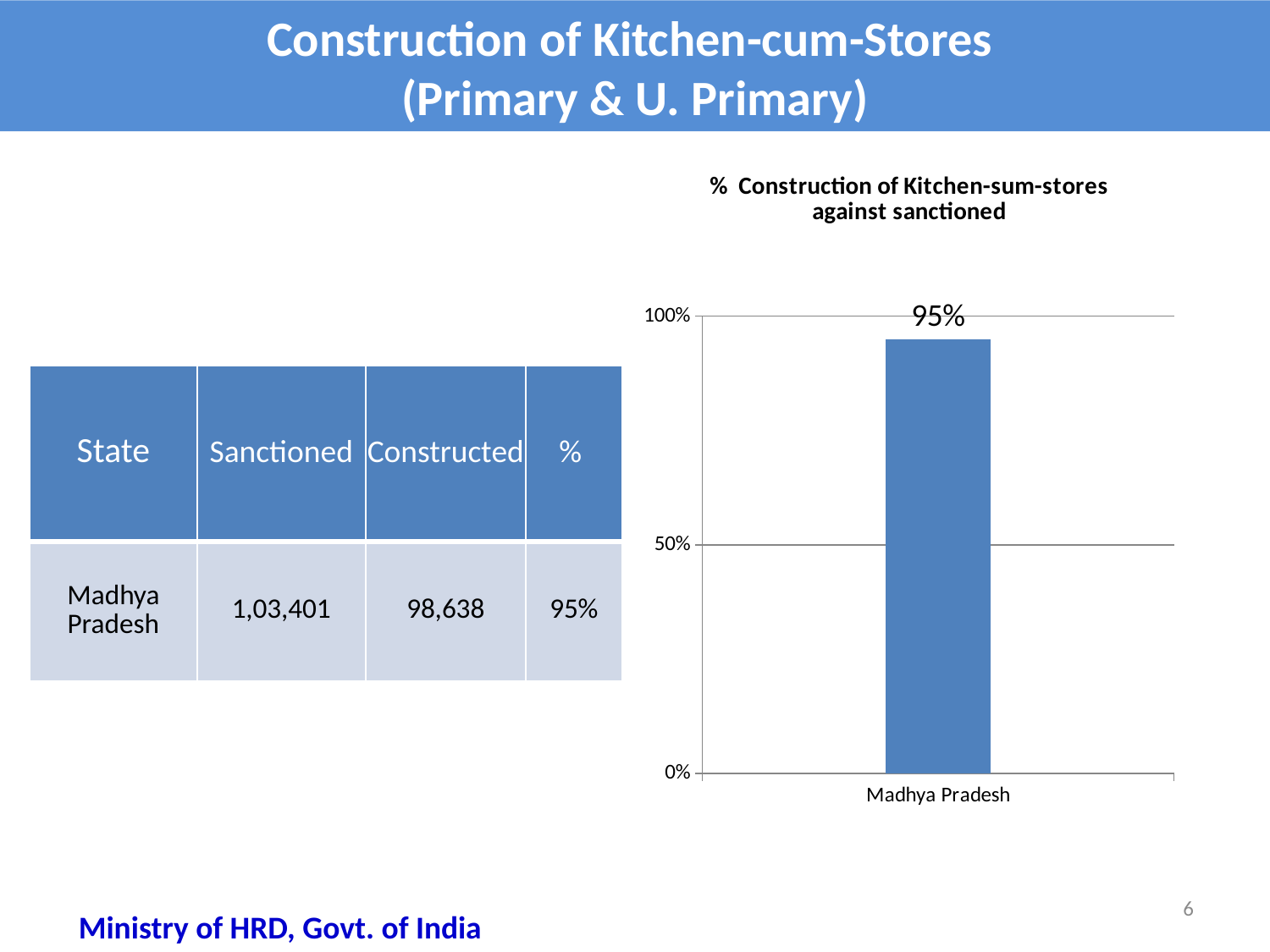
What is the highest value shown on the chart's vertical axis? 100% What is the title of the chart? % Construction of Kitchen-sum-stores against sanctioned Which category is shown on the x axis of the chart? Madhya Pradesh How many categories are plotted in the chart? 1 Is the value for Madhya Pradesh greater or less than 50%? greater What is the value for Madhya Pradesh in the chart? 95% What kind of chart is shown on the slide? bar chart